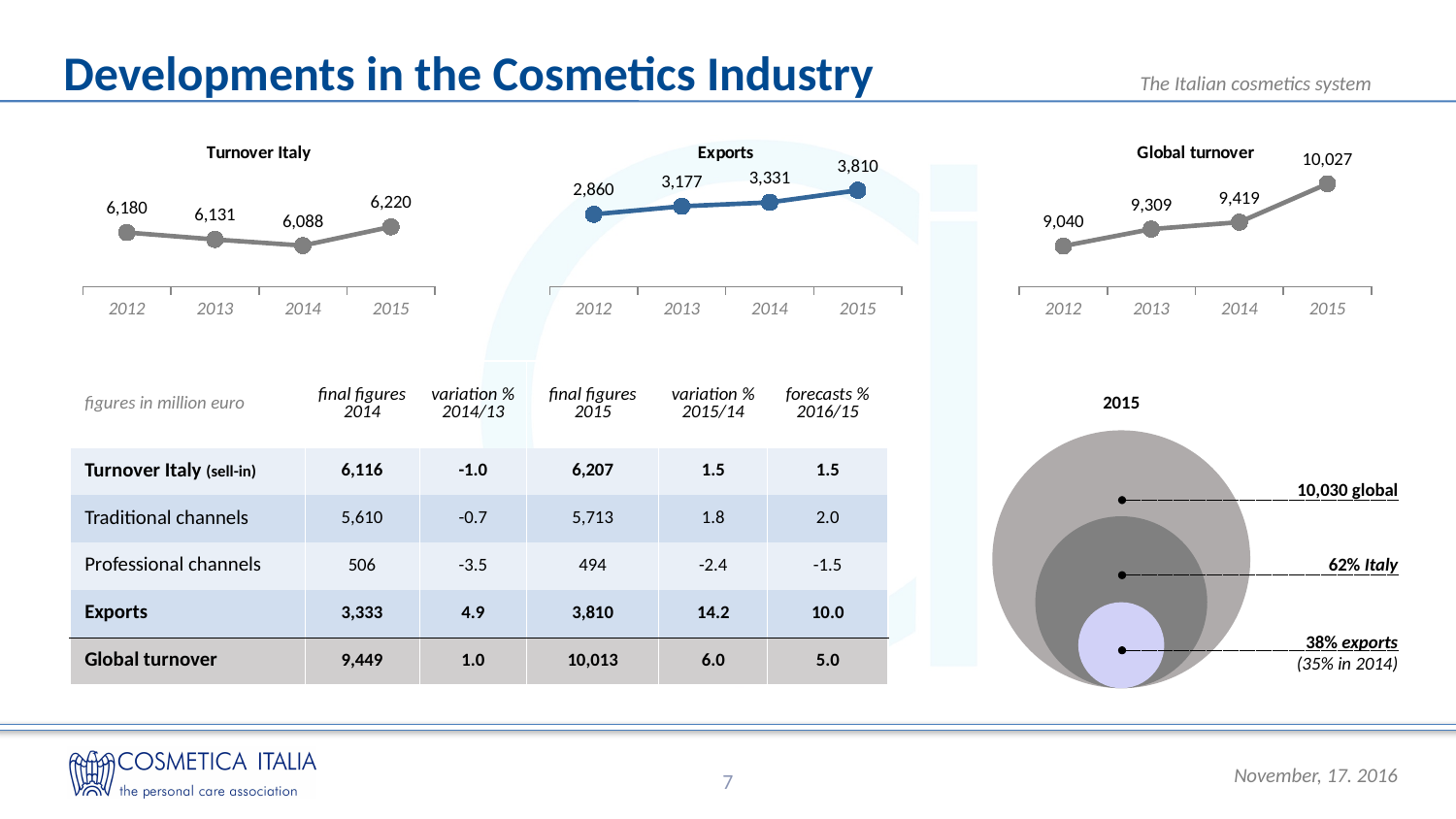
In the Exports chart, which year has the highest value? 2015 In the Global turnover chart, which is larger, the value for 2014 or the value for 2015? 2015 In the Exports chart, do the values rise or fall from 2012 to 2015? rise How many line charts are shown at the top of the slide? 3 In the Global turnover chart, what is the value for 2013? 9,309 In the Turnover Italy chart, what is the value for 2015? 6,220 What type of chart is the Exports chart? line chart In the Global turnover chart, how many data points are plotted? 4 In the Exports chart, what is the difference between the 2015 and 2012 values? 950 In the Turnover Italy chart, which year has the lowest value? 2014 In the Exports chart, what is the value for 2012? 2,860 In the Turnover Italy chart, what is the difference between the 2015 and 2014 values? 132